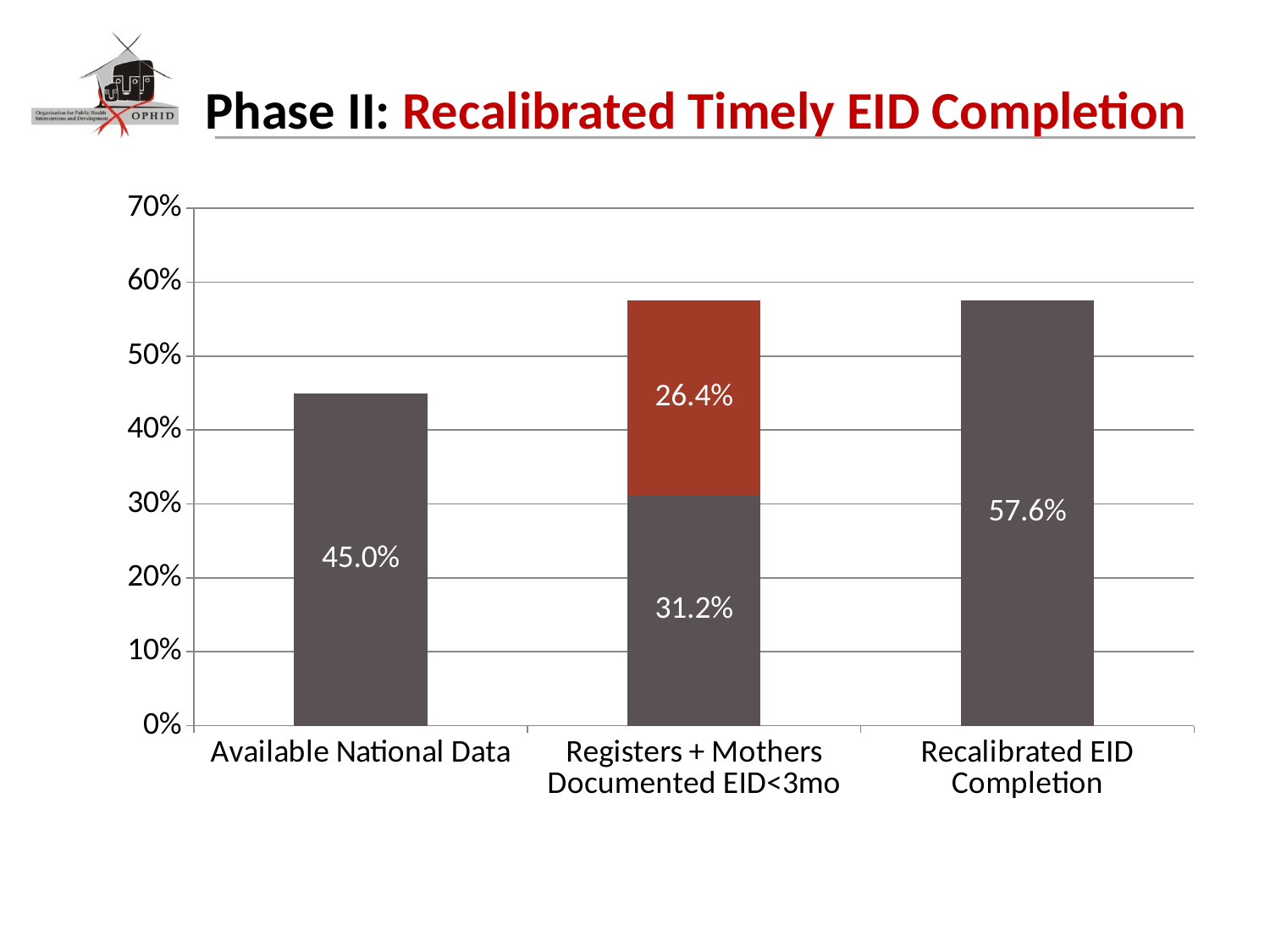
How many categories are shown on the x axis? 3 What is the title of the slide? Phase II: Recalibrated Timely EID Completion What kind of chart is shown on the slide? bar chart What is the value of the lower (grey) segment of the Registers + Mothers Documented EID<3mo bar? 31.2% What is the difference between Recalibrated EID Completion and Available National Data? 12.6% Is the value for Available National Data greater or less than 50%? less What is the value for Available National Data? 45.0% What is the value of the upper (red) segment of the Registers + Mothers Documented EID<3mo bar? 26.4% Which category has the lowest value? Available National Data What is the value for Recalibrated EID Completion? 57.6% What is the total of the stacked bar for Registers + Mothers Documented EID<3mo? 57.6% Which is larger: the value for Available National Data or the value for Recalibrated EID Completion? Recalibrated EID Completion